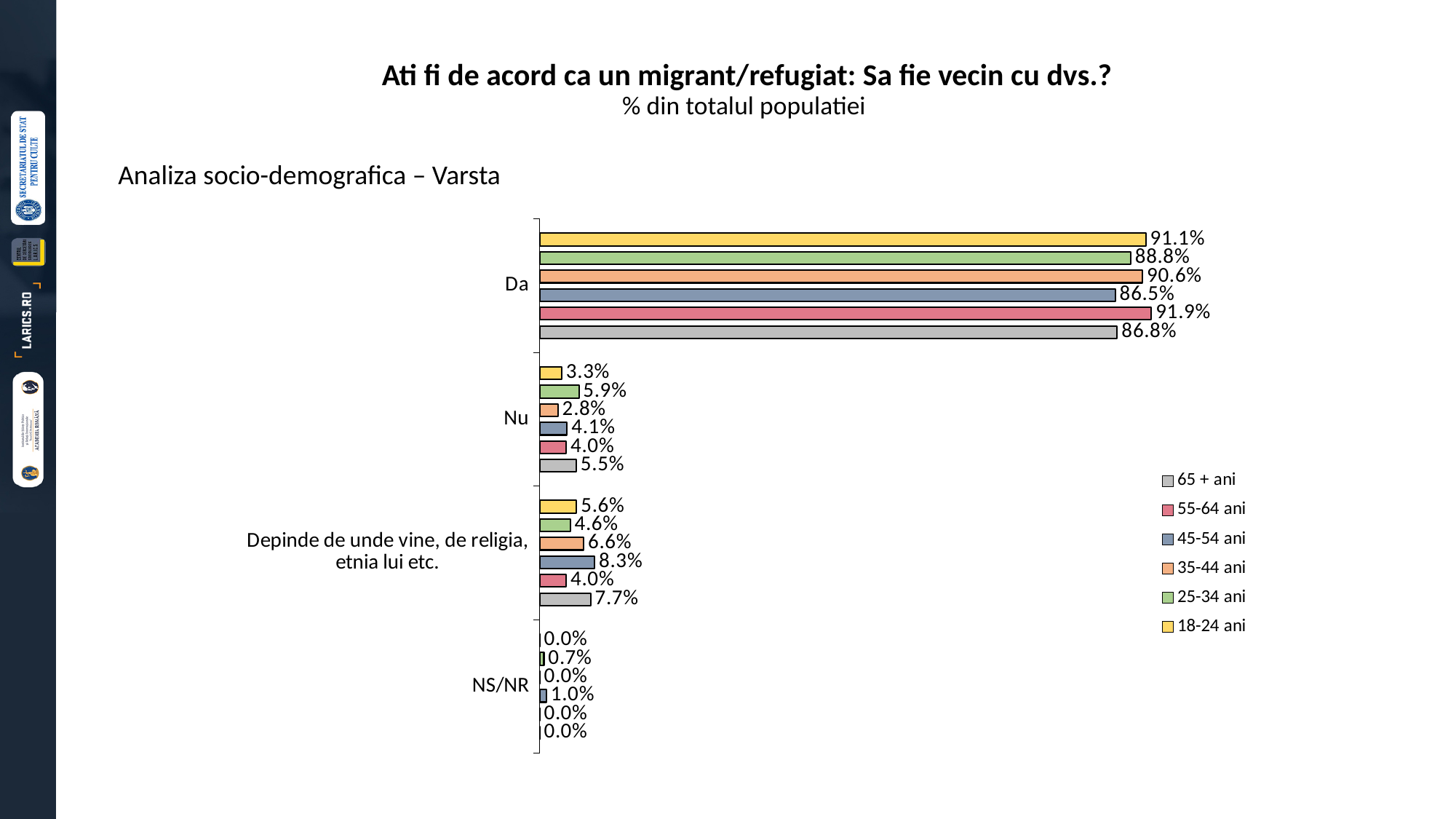
Which age group has the lowest value in the 'Nu' category? 35-44 ani What is the value for the 25-34 ani group in the 'NS/NR' category? 0.7% What is the difference between the 18-24 ani and 45-54 ani values in the 'Da' category? 4.6% How many response categories are shown on the chart? 4 What is the subtitle shown under the chart title? % din totalul populatiei What is the value for the 45-54 ani group in the 'Depinde de unde vine, de religia, etnia lui etc.' category? 8.3% How many series does the legend list? 6 In the 'Depinde de unde vine, de religia, etnia lui etc.' category, which is larger: the value for 65 + ani or for 35-44 ani? 65 + ani What kind of chart is shown on the slide? bar chart Which age group has the highest value in the 'Da' category? 55-64 ani What is the value for the 18-24 ani group in the 'Nu' category? 3.3% What is the value for the 55-64 ani group in the 'Da' category? 91.9%